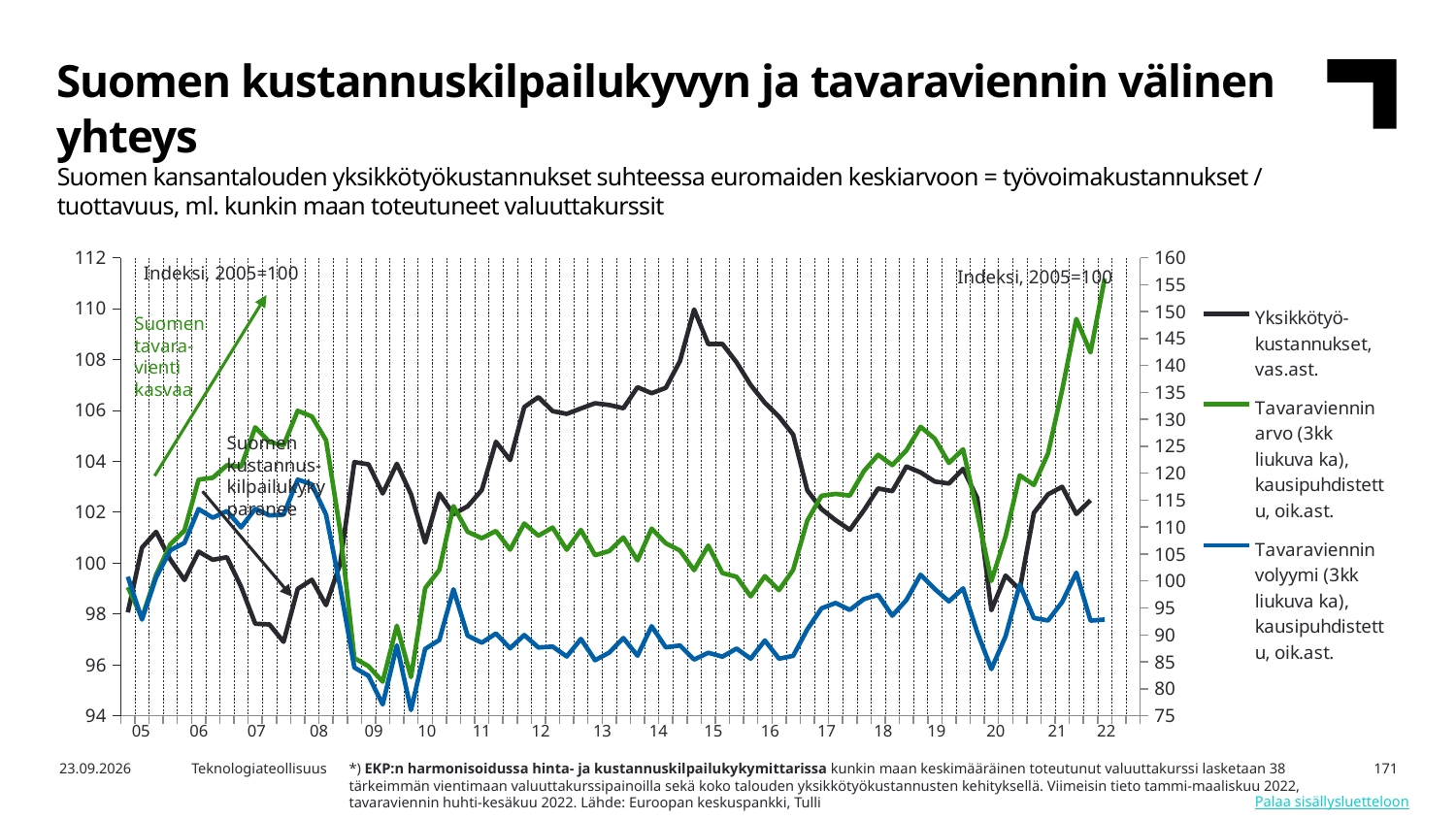
Is the value of Yksikkötyökustannukset at its low point in 2020 greater or less than 100? less How many series does the legend list? 3 Does the Tavaraviennin arvo line rise or fall between 2020 and 2022? rise How many year labels are shown on the x axis? 18 Is the value of Tavaraviennin arvo at the end of the series in 2022 greater or less than 150? greater Is the value of Yksikkötyökustannukset at its peak around 2014–15 greater or less than 108? greater Which series is plotted on the left axis (vas.ast.)? Yksikkötyökustannukset At the end of the series in 2022, which is higher on the right axis: Tavaraviennin arvo or Tavaraviennin volyymi? Tavaraviennin arvo What colour is the line for Tavaraviennin volyymi? blue What kind of chart is shown on the slide? line chart